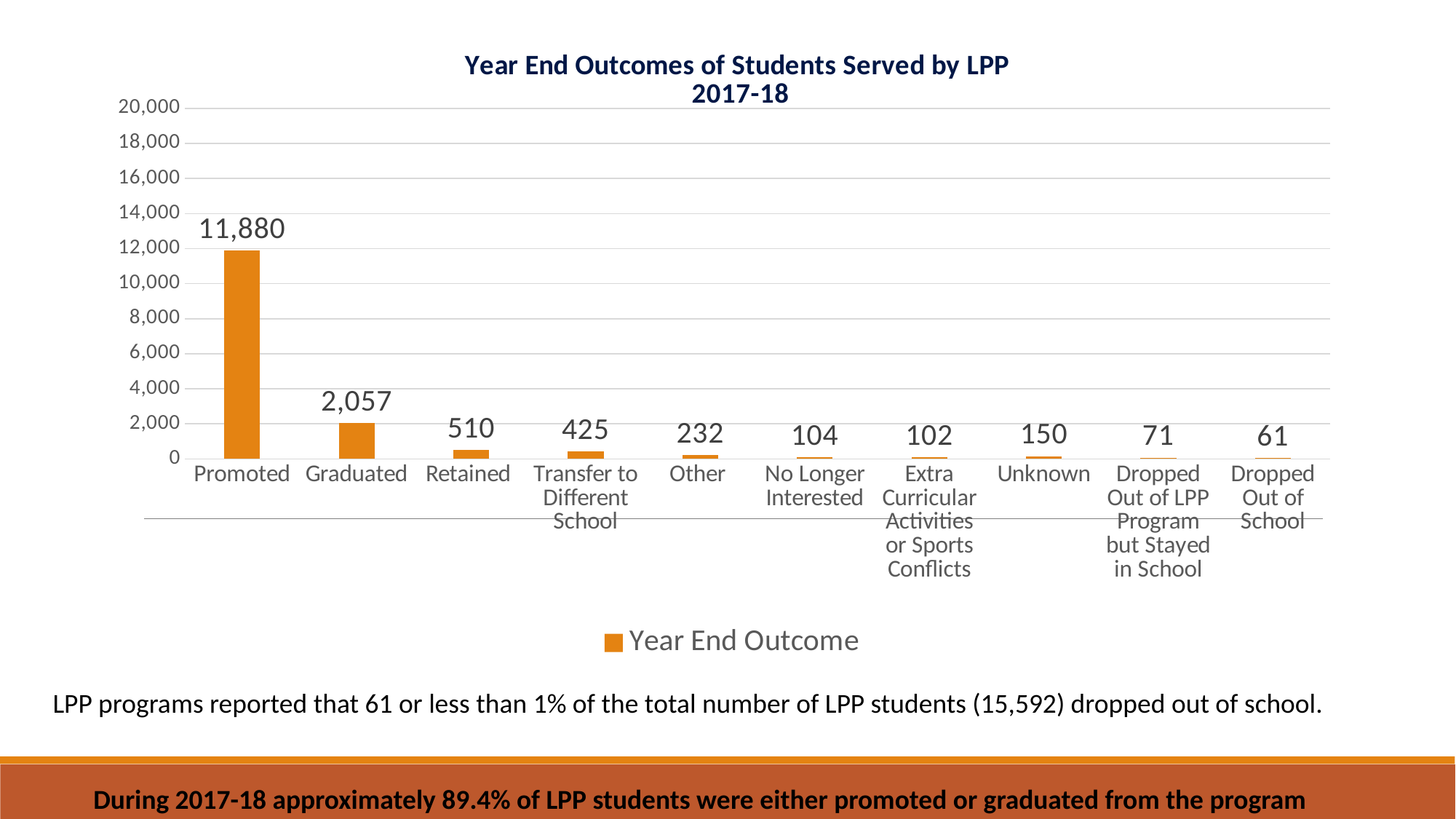
What is the difference between the values for Promoted and Graduated? 9,823 What is the value for Dropped Out of School? 61 What is the title of the chart? Year End Outcomes of Students Served by LPP 2017-18 What is the value for Transfer to Different School? 425 Which is larger, the value for Retained or the value for Unknown? Retained Which category has the lowest value? Dropped Out of School What is the value for Promoted? 11,880 How many categories are shown on the x axis? 10 What kind of chart is shown on the slide? Bar chart Which category has the highest value? Promoted How many series does the legend list? 1 What is the value for Graduated? 2,057